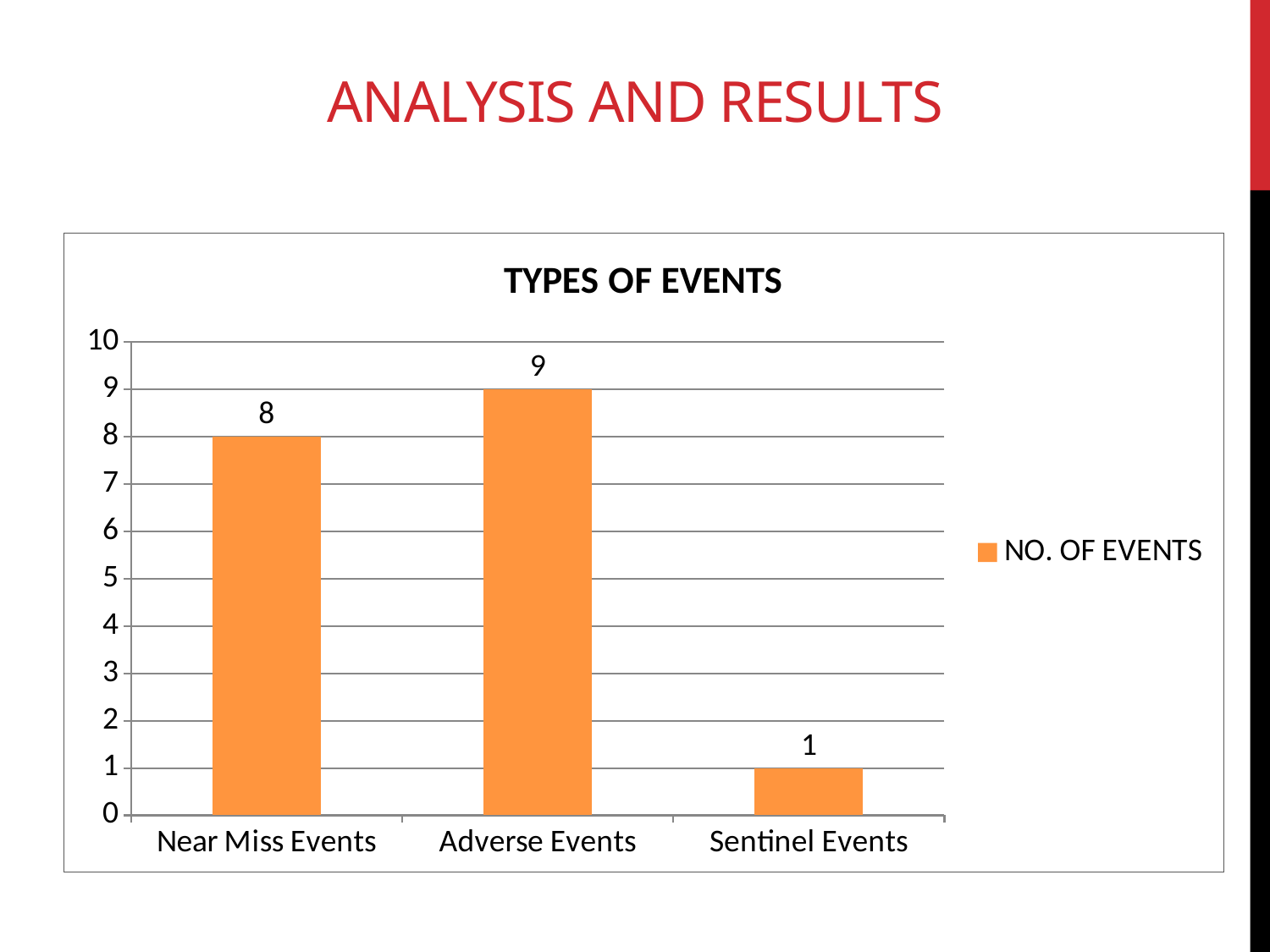
What is the number of events for Sentinel Events? 1 What is the difference between the number of Adverse Events and Near Miss Events? 1 What type of chart is shown on the slide? Bar chart Which category has the lowest number of events? Sentinel Events What is the number of events for Adverse Events? 9 Is the value for Near Miss Events greater or less than 5? greater What is the number of events for Near Miss Events? 8 Which category has the highest number of events? Adverse Events How many categories are shown on the x axis? 3 What is the difference between the number of Adverse Events and Sentinel Events? 8 Which is larger, the number of Near Miss Events or Sentinel Events? Near Miss Events What is the title of the chart? TYPES OF EVENTS